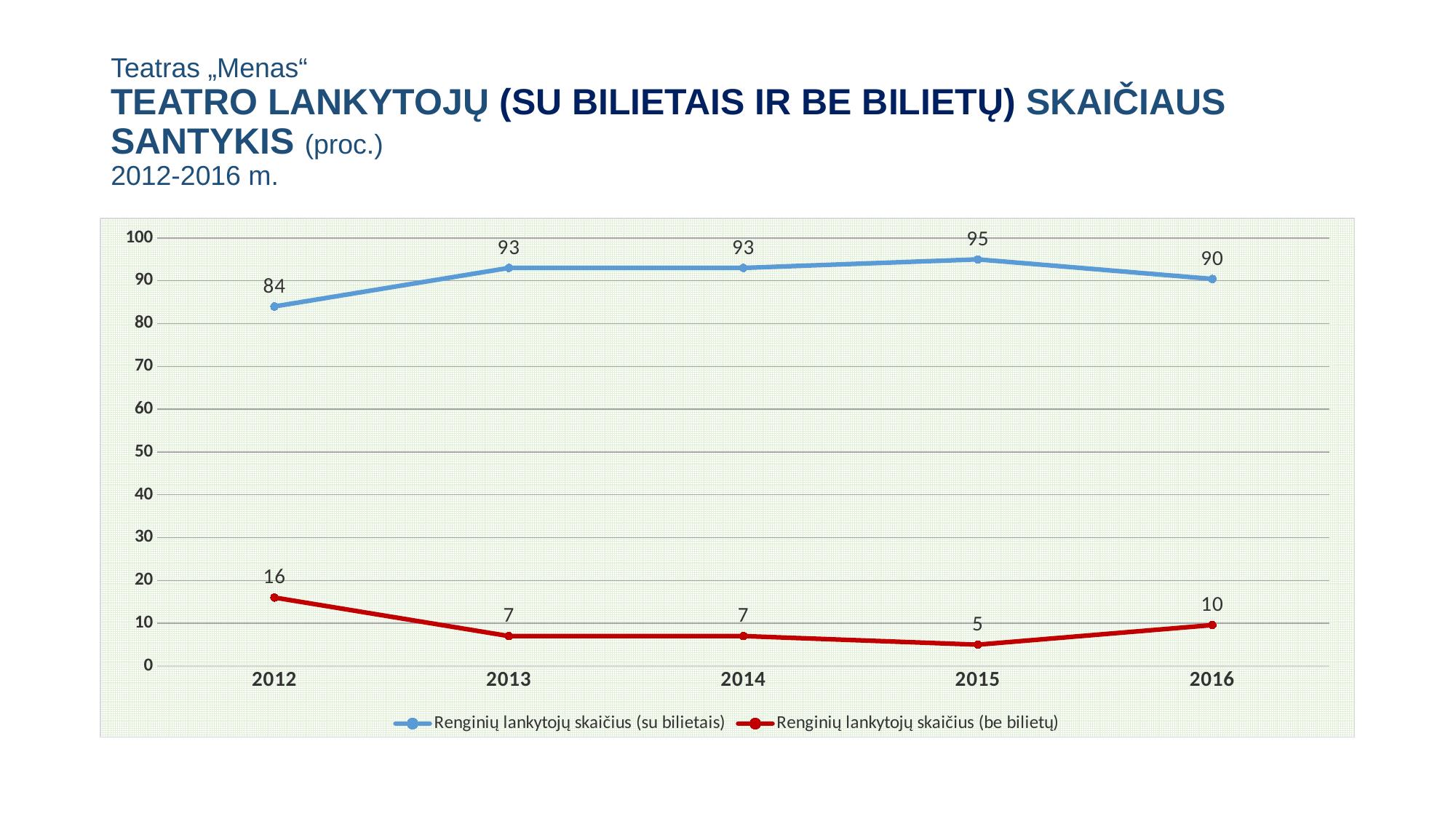
What is the value for 'Renginių lankytojų skaičius (be bilietų)' in 2016? 10 In which year is 'Renginių lankytojų skaičius (su bilietais)' lowest? 2012 How many years are shown on the x axis? 5 What is the value for 'Renginių lankytojų skaičius (su bilietais)' in 2015? 95 In which year is 'Renginių lankytojų skaičius (be bilietų)' highest? 2012 In which year is 'Renginių lankytojų skaičius (be bilietų)' lowest? 2015 How many series does the legend list? 2 Does the 'Renginių lankytojų skaičius (be bilietų)' series rise or fall from 2012 to 2013? fall What is the difference between the 'su bilietais' values in 2015 and 2016? 5 What is the value for 'Renginių lankytojų skaičius (su bilietais)' in 2012? 84 What kind of chart is shown on the slide? line chart Which is larger: the 'be bilietų' value in 2012 or in 2016? 2012